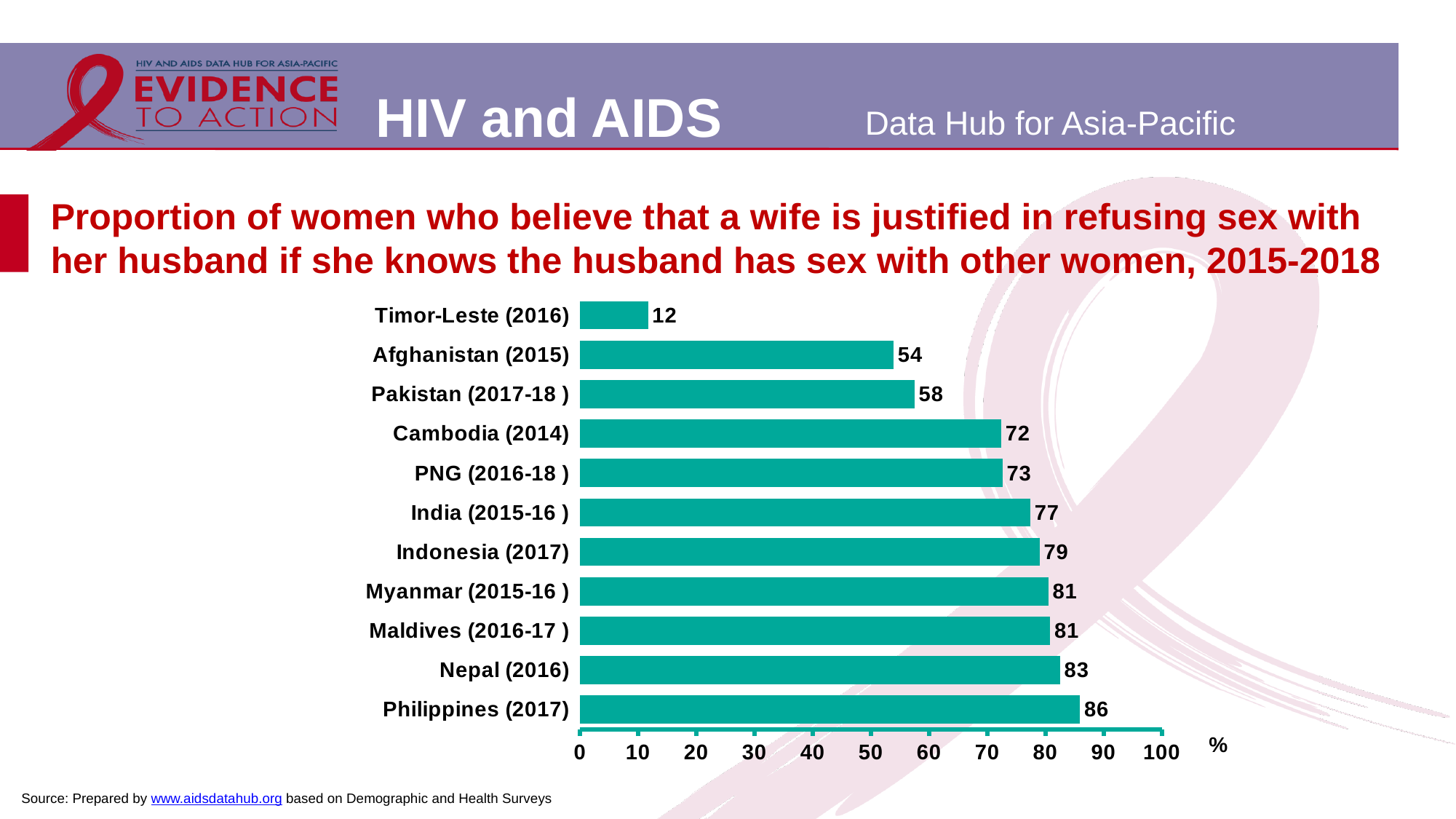
Which country has the highest value? Philippines (2017) What is the difference between the values for Nepal (2016) and Afghanistan (2015)? 29 What is the value for Cambodia (2014)? 72 What is the value for Myanmar (2015-16)? 81 Which country has the lowest value? Timor-Leste (2016) How many countries are shown in the chart? 11 What unit is shown at the end of the x axis? % What is the value for Philippines (2017)? 86 What kind of chart is shown on the slide? Bar chart What is the value for Timor-Leste (2016)? 12 Which is larger, the value for India (2015-16) or the value for Pakistan (2017-18)? India (2015-16) Is the value for Indonesia (2017) greater or less than 70? greater